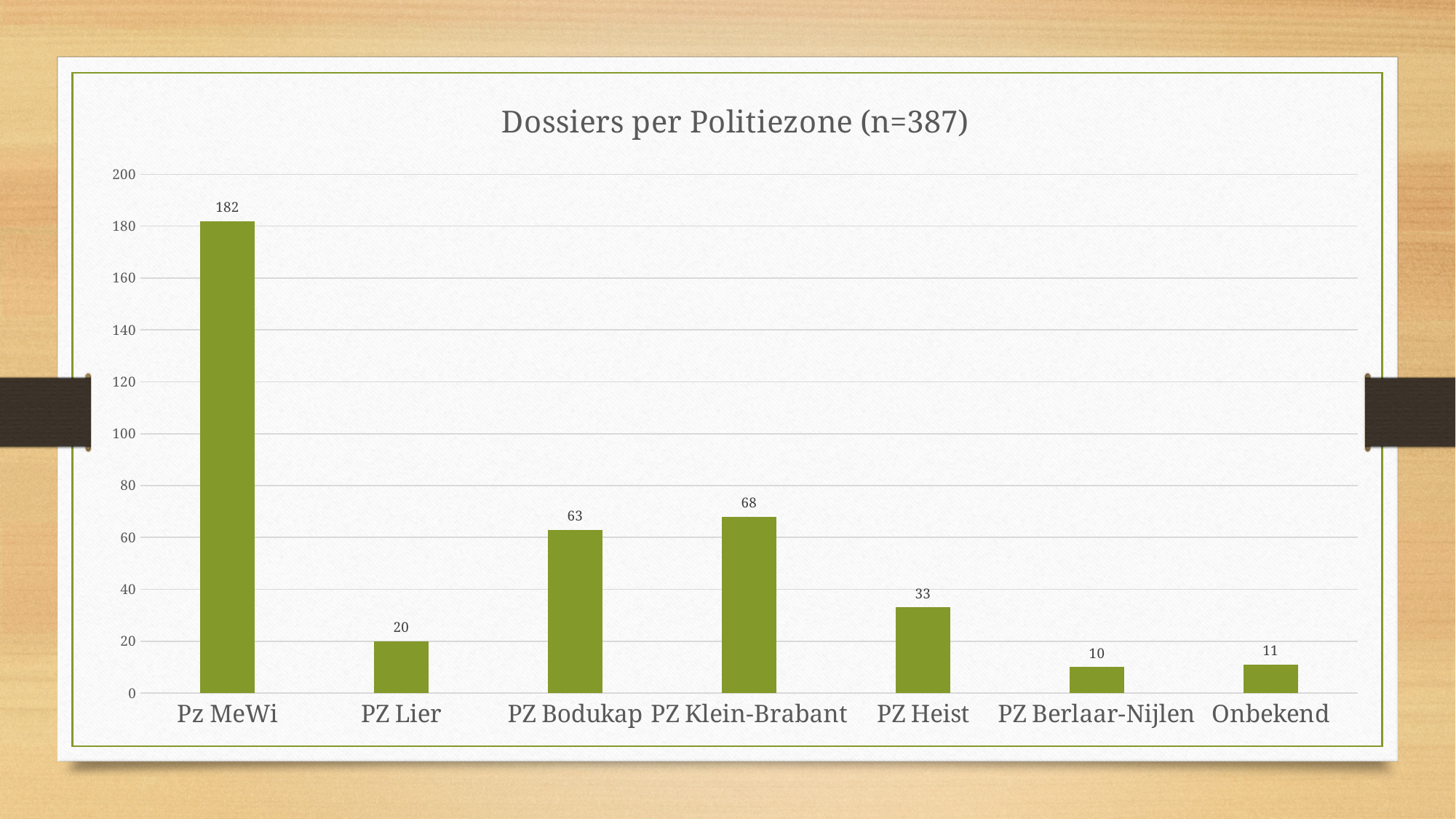
Which category has the lowest value? PZ Berlaar-Nijlen Is the value for PZ Bodukap greater or less than 80? less What is the value for PZ Klein-Brabant? 68 How many categories are shown on the x axis? 7 Which is larger, the value for PZ Lier or the value for PZ Heist? PZ Heist What kind of chart is shown on the slide? bar chart What is the value for Pz MeWi? 182 What is the difference between the values for PZ Klein-Brabant and PZ Bodukap? 5 What is the value for PZ Berlaar-Nijlen? 10 Which politiezone has the highest number of dossiers? Pz MeWi What is the title of the chart? Dossiers per Politiezone (n=387) What is the difference between the values for Pz MeWi and PZ Heist? 149